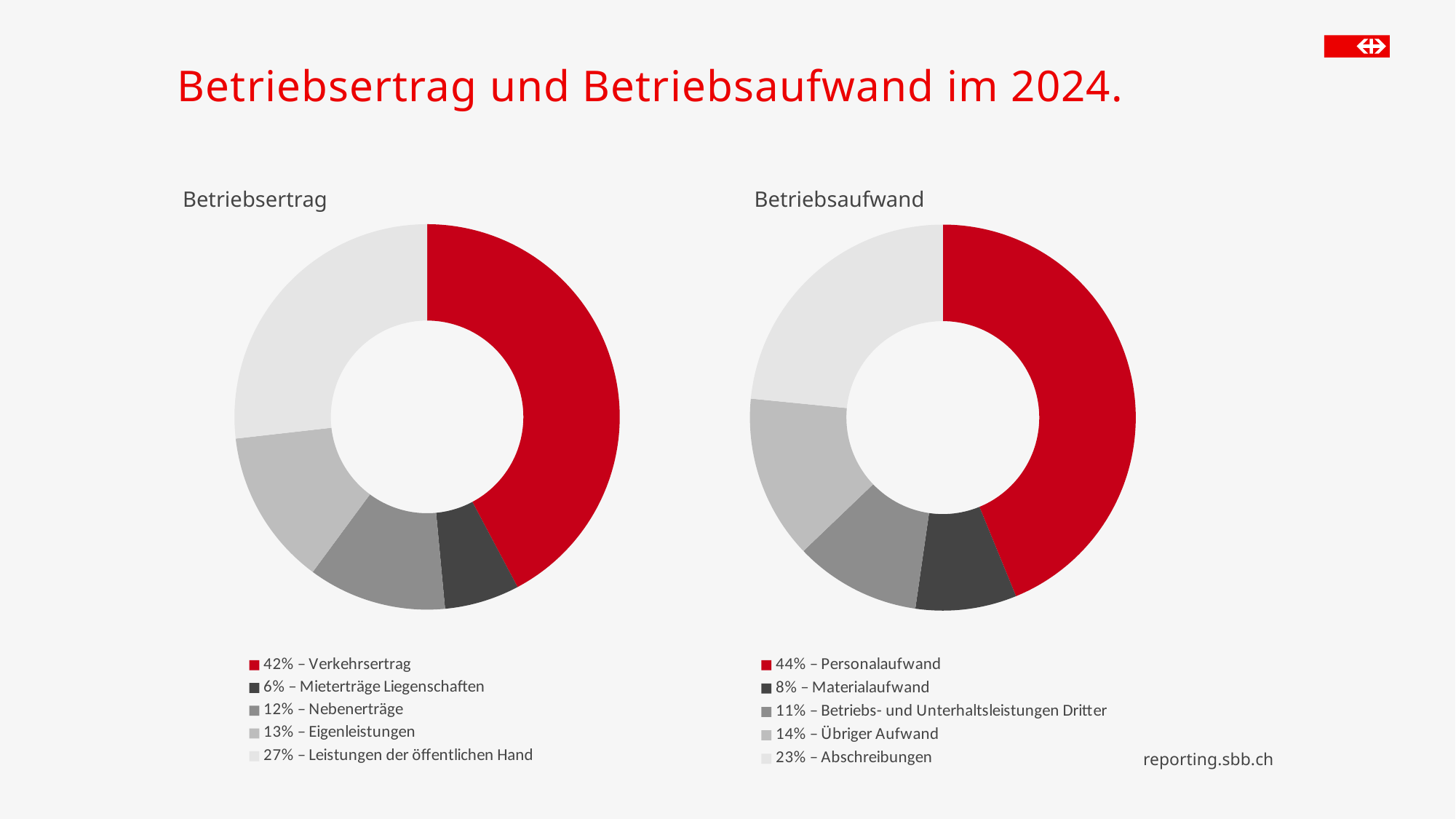
In the Betriebsaufwand chart, which is larger: Übriger Aufwand or Betriebs- und Unterhaltsleistungen Dritter? Übriger Aufwand In the Betriebsaufwand chart, what share does Abschreibungen have? 23% In the Betriebsertrag chart, what share does Verkehrsertrag have? 42% What kind of chart is the Betriebsaufwand chart? Doughnut chart How many categories does the Betriebsertrag chart show? 5 What is the title of the slide? Betriebsertrag und Betriebsaufwand im 2024. In the Betriebsertrag chart, which category has the smallest share? Mieterträge Liegenschaften In the Betriebsertrag chart, what share does Leistungen der öffentlichen Hand have? 27% In the Betriebsertrag chart, what is the difference in percentage points between Verkehrsertrag and Leistungen der öffentlichen Hand? 15 In the Betriebsaufwand chart, which category has the largest share? Personalaufwand In the Betriebsaufwand chart, what share does Personalaufwand have? 44% In the Betriebsaufwand chart, which category has the smallest share? Materialaufwand